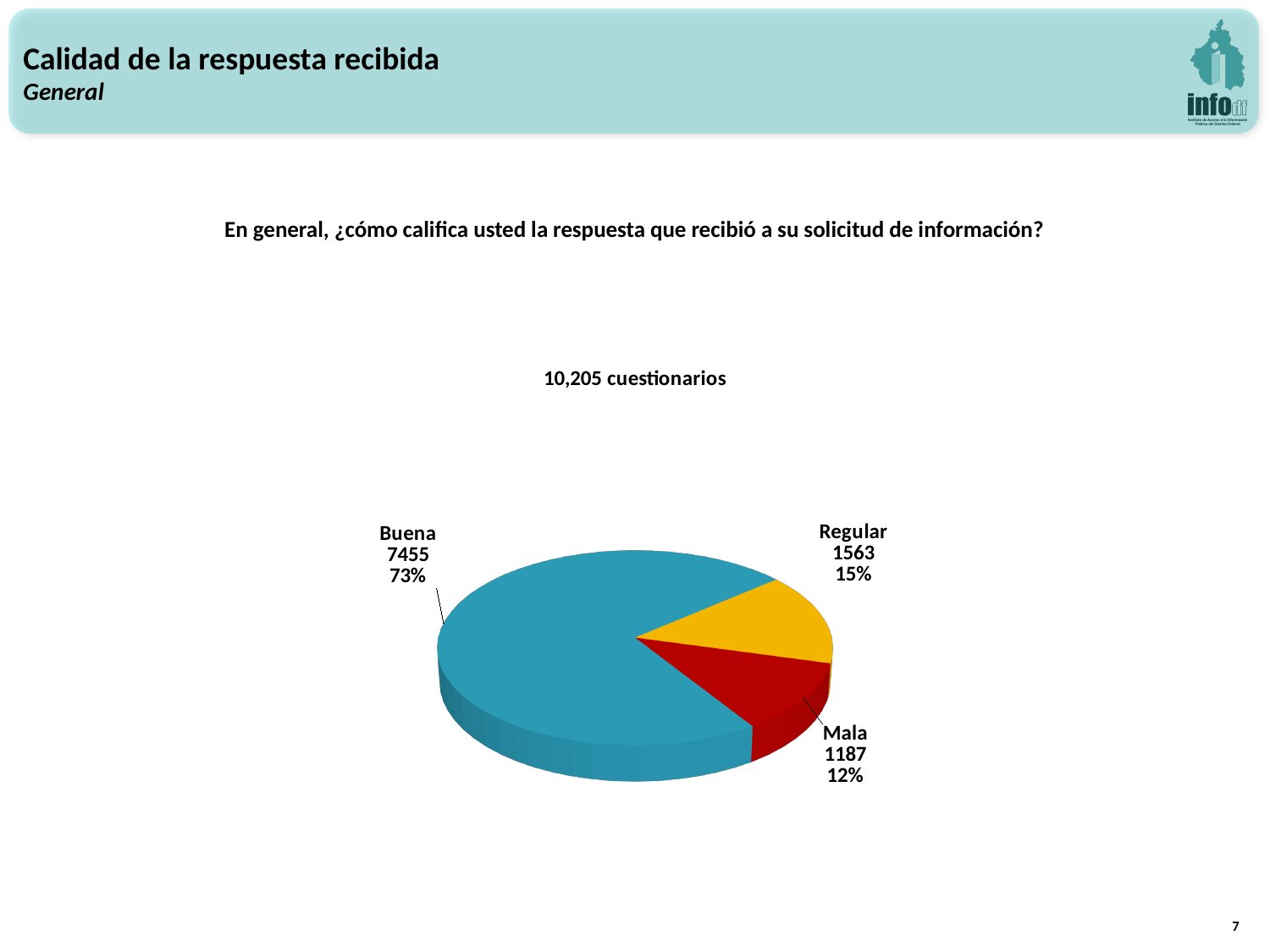
What is the value for Mala? 1187 What kind of chart is shown on the slide? pie chart Which category has the smallest slice? Mala How many slices does the pie chart have? 3 Which category has the largest slice? Buena Which is larger, the value for Regular or the value for Mala? Regular What share of the pie does Mala represent? 12% What is the value for Buena? 7455 What is the difference between the values for Regular and Mala? 376 What share of the pie does Buena represent? 73% What colour is the Buena slice? blue What is the value for Regular? 1563